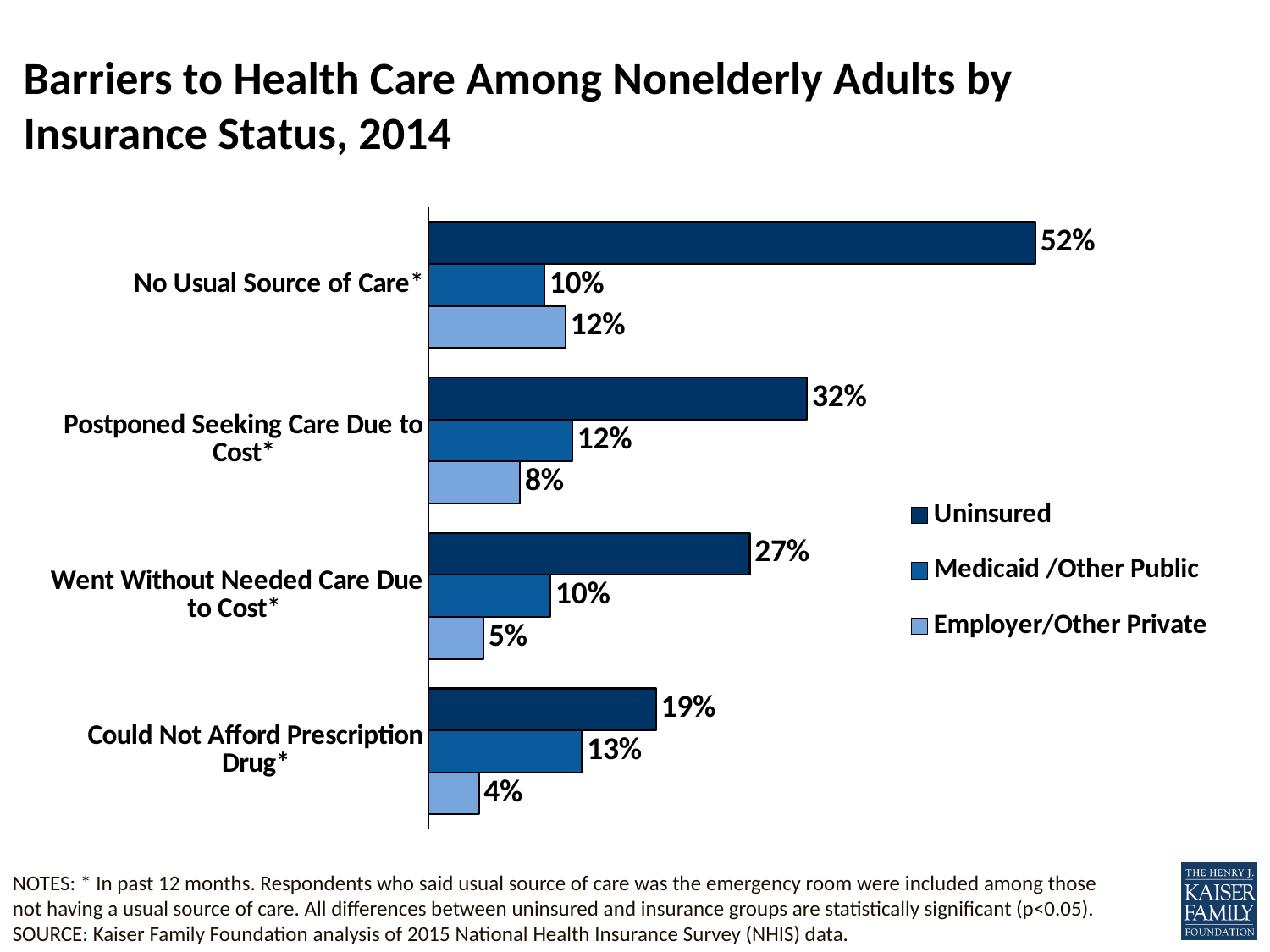
For Could Not Afford Prescription Drug, which is larger: the Medicaid/Other Public value or the Employer/Other Private value? Medicaid/Other Public Which barrier has the lowest value for the Employer/Other Private series? Could Not Afford Prescription Drug What kind of chart is shown on the slide? Bar chart Which series is shown in the lightest blue colour? Employer/Other Private What is the value for Uninsured adults with No Usual Source of Care? 52% What is the value for Medicaid/Other Public adults who Postponed Seeking Care Due to Cost? 12% Which barrier has the highest value for the Uninsured series? No Usual Source of Care What is the title of the chart? Barriers to Health Care Among Nonelderly Adults by Insurance Status, 2014 How many barrier categories are shown on the chart? 4 How many series does the legend list? 3 What is the value for Employer/Other Private adults who Could Not Afford Prescription Drug? 4% What is the difference between the Uninsured and Employer/Other Private values for Went Without Needed Care Due to Cost? 22%